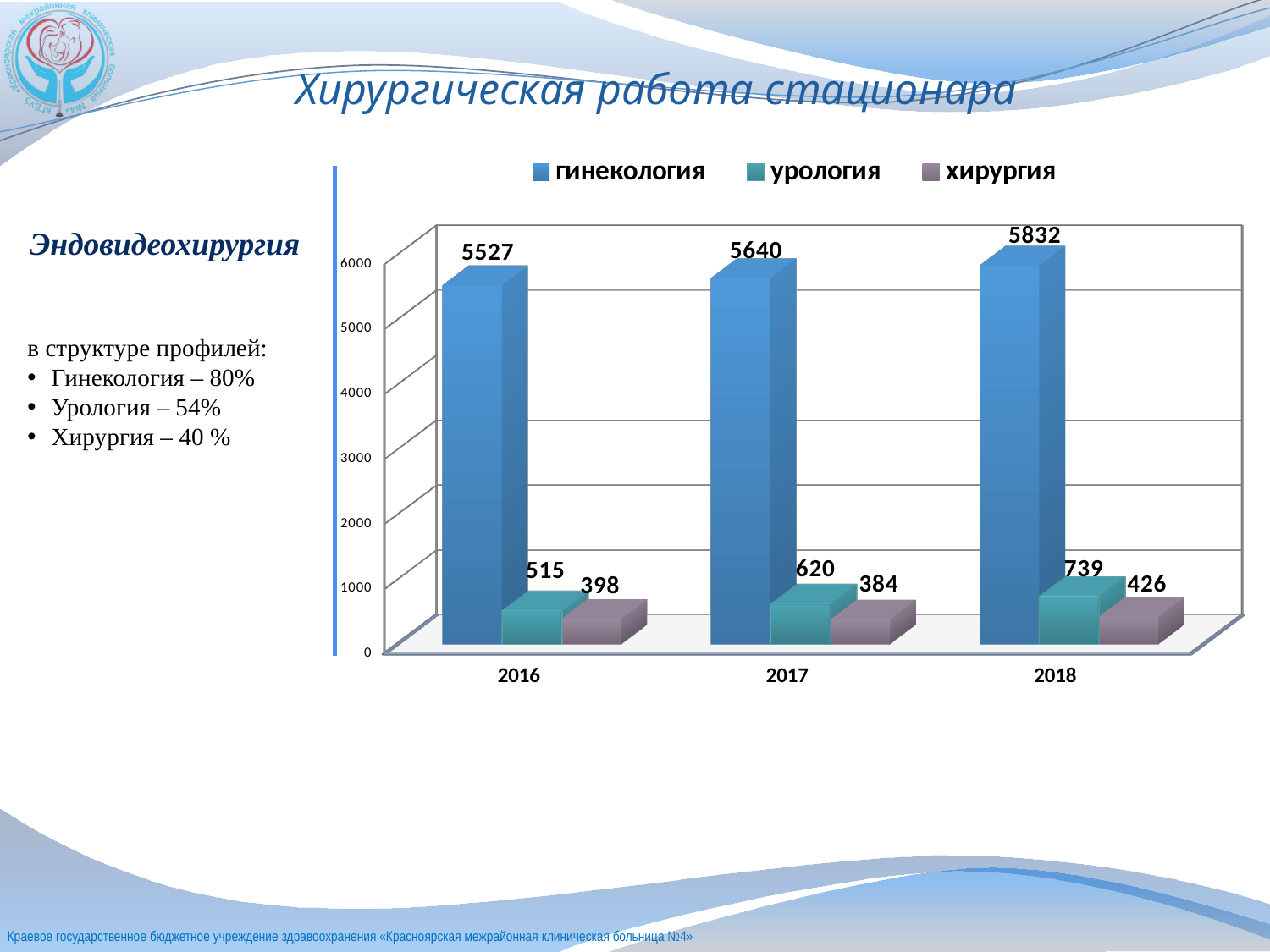
How many years are shown on the x axis? 3 What is the difference between the гинекология values for 2018 and 2016? 305 What is the value for урология in 2017? 620 In which year is the value for хирургия lowest? 2017 What kind of chart is shown on the slide? bar chart Is the value for гинекология in 2017 greater or less than 5000? greater What is the value for хирургия in 2018? 426 How many series does the legend list? 3 Which is larger in 2017: урология or хирургия? урология Does the value for урология rise or fall from 2016 to 2018? rise In which year is the value for гинекология highest? 2018 What is the value for гинекология in 2016? 5527